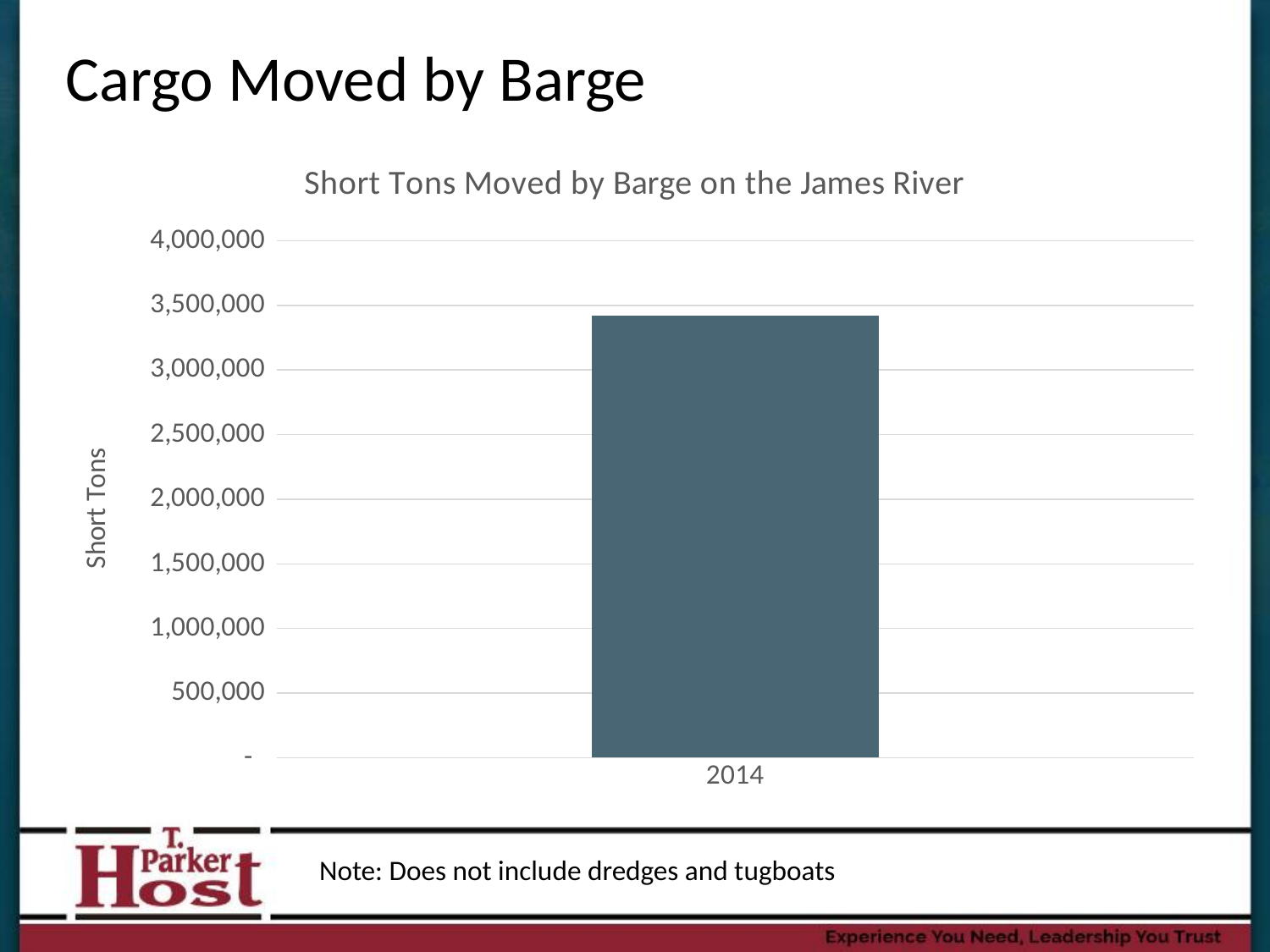
Which year is shown on the x axis of the chart? 2014 Is the value for 2014 greater or less than 4,000,000? less What is the highest value shown on the y axis of the chart? 4,000,000 Is the value for 2014 greater or less than 2,000,000? greater What kind of chart is shown on the slide? bar chart Is the value for 2014 greater or less than 3,500,000? less How many bars are plotted in the chart? 1 What is the title of the chart? Short Tons Moved by Barge on the James River